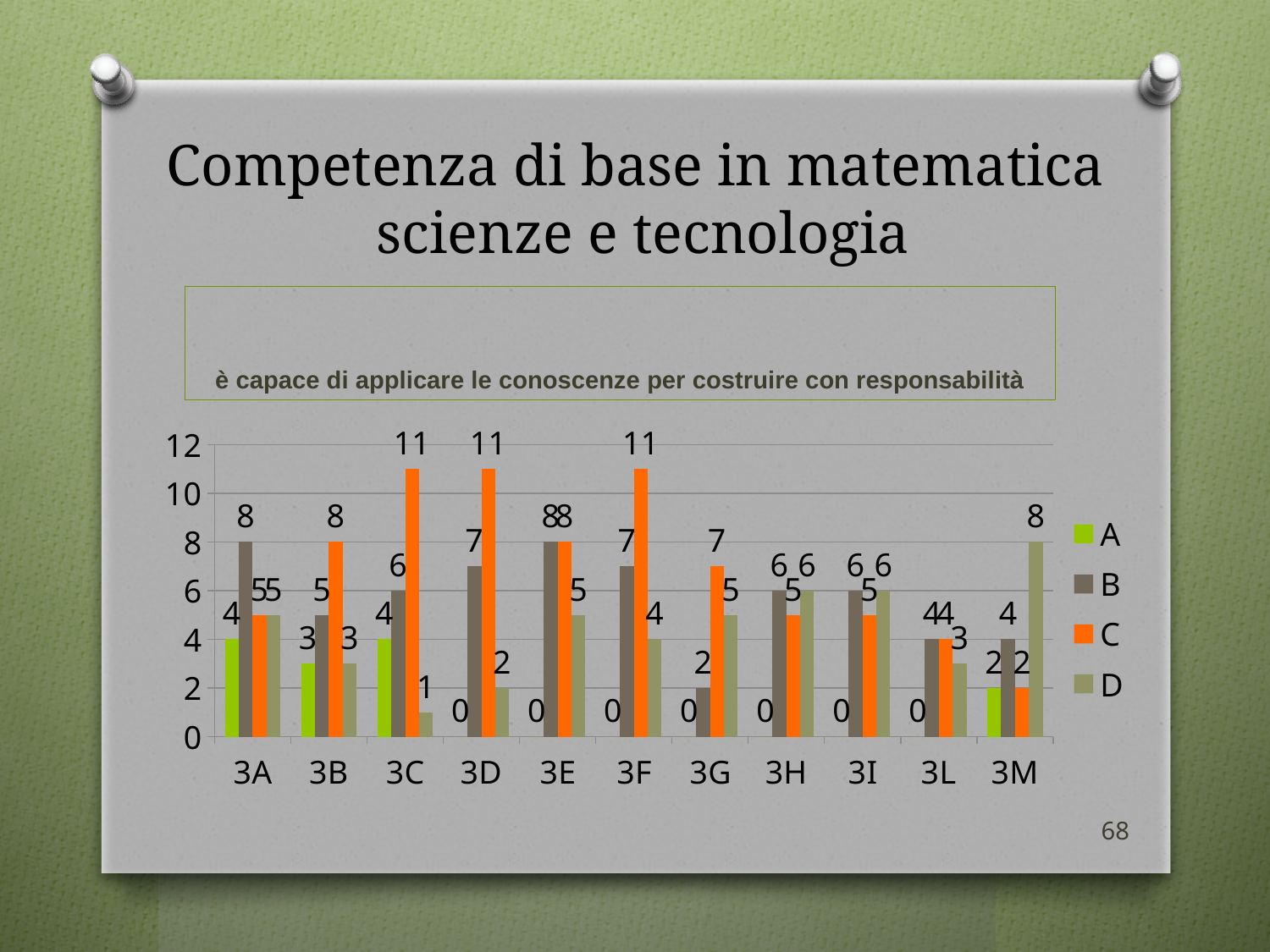
How many categories are shown on the x axis? 11 What is the value of series D for 3M? 8 What kind of chart is shown on the slide? bar chart Which category has the lowest value for series D? 3C Which is larger for 3B: the value of series B or the value of series C? series C Which category has the highest value for series D? 3M How many series does the legend list? 4 What is the difference between the series C value and the series A value for 3C? 7 What is the value of series C for 3C? 11 What is the value of series A for 3B? 3 What colour represents series C in the legend? orange What is the value of series B for 3A? 8